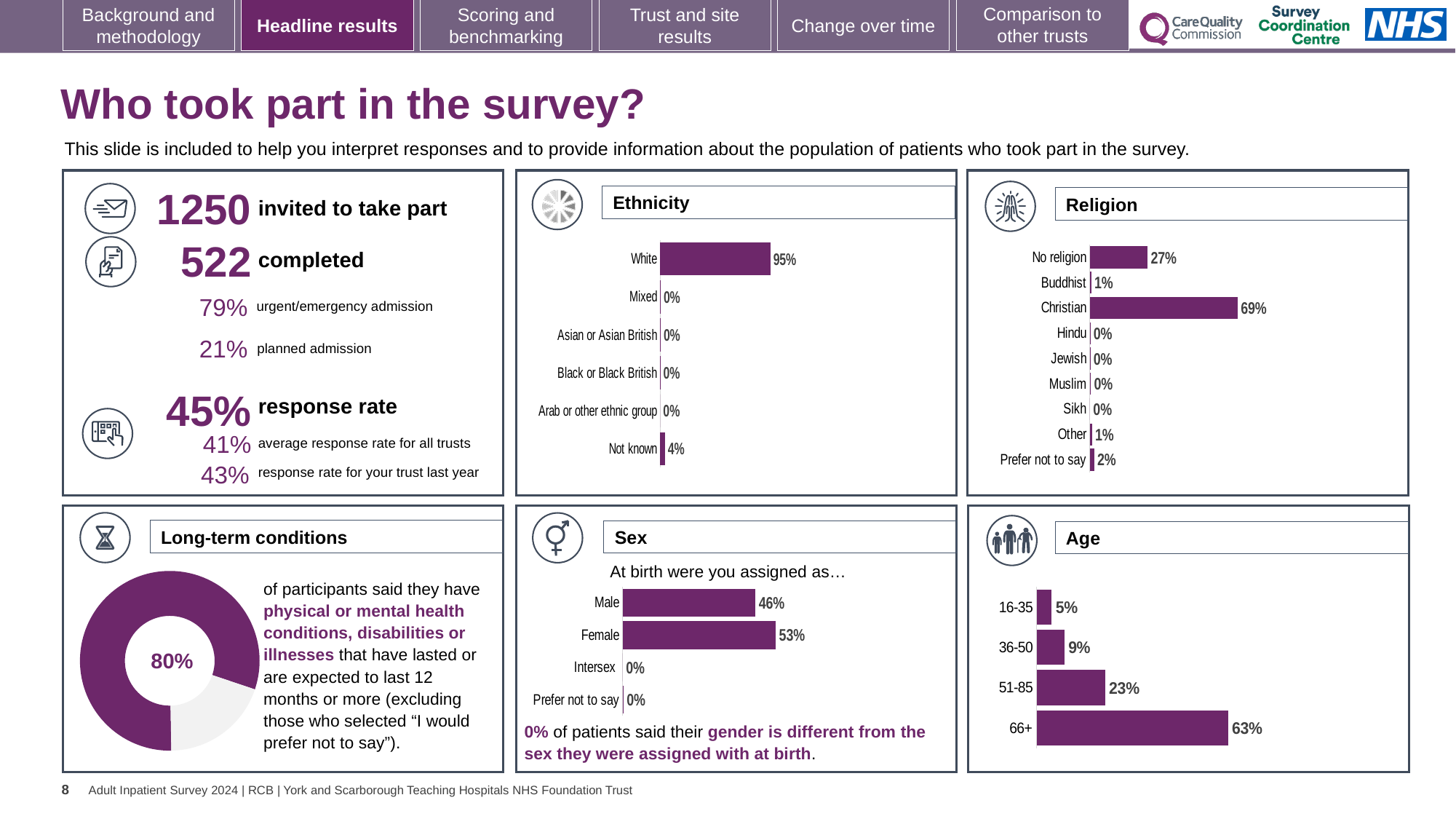
In the Ethnicity chart, what percentage of respondents were White? 95% In the Religion chart, what is the difference between the Christian and No religion percentages? 42% In the Age chart, what is the percentage for the 51-85 age group? 23% In the Religion chart, which religion category has the highest percentage? Christian In the Sex chart, which is larger, Male or Female? Female In the Age chart, which age group has the highest percentage? 66+ In the Age chart, do the values rise or fall as the age groups increase from 16-35 to 66+? rise In the Religion chart, what is the percentage for No religion? 27% In the Ethnicity chart, what percentage of respondents were Not known? 4% What kind of chart is used in the Long-term conditions panel? doughnut chart In the Sex chart, what is the difference between the Female and Male percentages? 7% In the Religion chart, how many religion categories are shown? 9